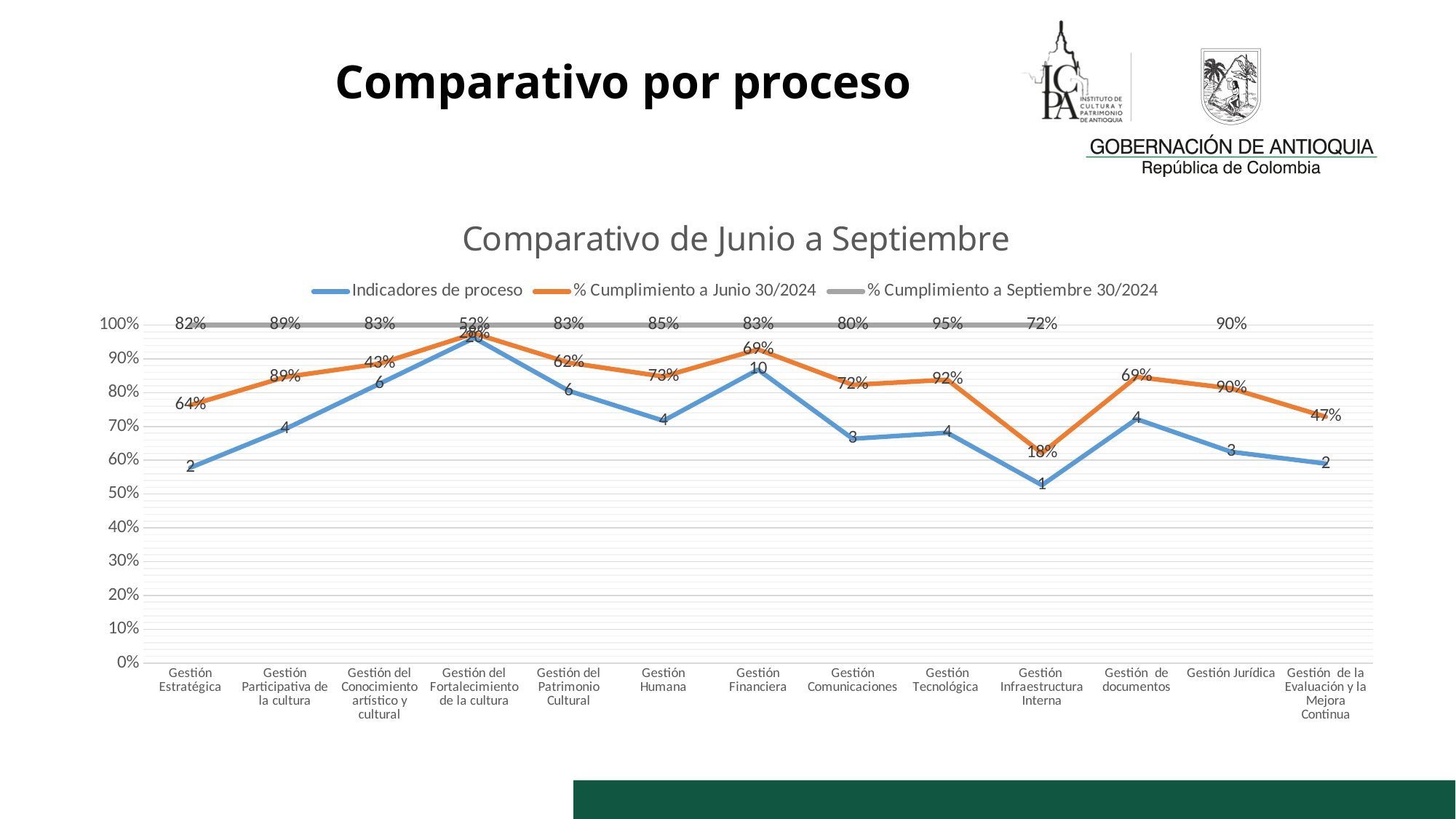
Which category has the highest value of Indicadores de proceso? Gestión del Fortalecimiento de la cultura What is the value of Indicadores de proceso for Gestión del Fortalecimiento de la cultura? 20 How many series does the legend of the chart list? 3 Which has the larger % Cumplimiento a Junio 30/2024 value, Gestión Jurídica or Gestión de la Evaluación y la Mejora Continua? Gestión Jurídica How many process categories are shown along the x axis of the chart? 13 Which category has the lowest value of Indicadores de proceso? Gestión Infraestructura Interna What is the difference between the Indicadores de proceso values for Gestión Financiera and Gestión Humana? 6 What is the value of Indicadores de proceso for Gestión Financiera? 10 What is the title of the chart? Comparativo de Junio a Septiembre What is the % Cumplimiento a Junio 30/2024 value labelled for Gestión Tecnológica? 92% What kind of chart is shown on the slide? line chart What is the % Cumplimiento a Junio 30/2024 value labelled for Gestión Infraestructura Interna? 18%